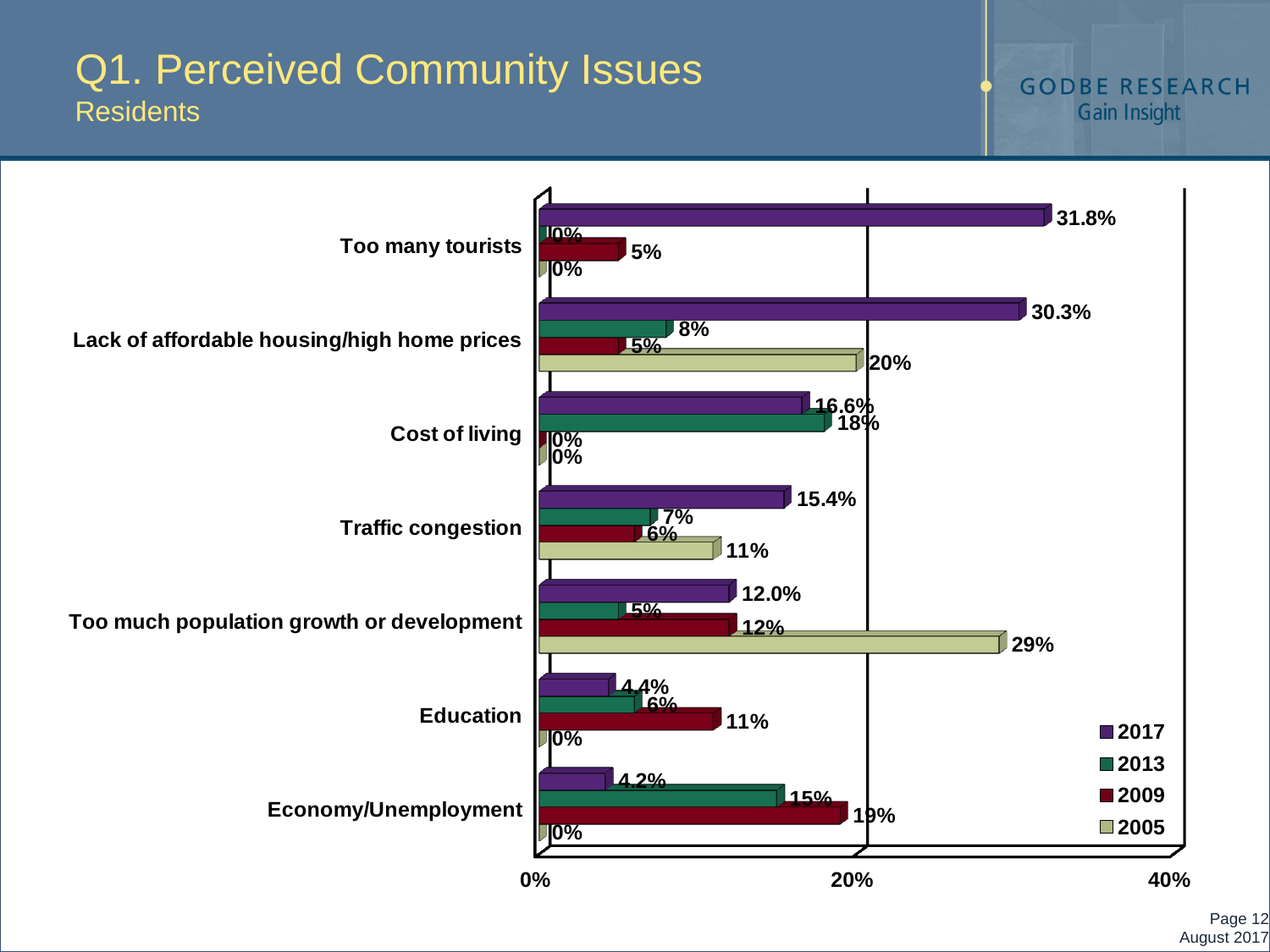
Which is larger for Traffic congestion: the 2017 value or the 2005 value? 2017 What is the 2009 value for Economy/Unemployment? 19% What is the difference between the 2017 and 2005 values for Lack of affordable housing/high home prices? 10.3% Which category has the highest 2017 value? Too many tourists How many series does the legend list? 4 What is the 2013 value for Cost of living? 18% How many categories are shown on the chart? 7 Is the 2005 value for Too much population growth or development greater or less than 20%? greater What is the 2017 value for Too many tourists? 31.8% What is the 2005 value for Too much population growth or development? 29% Which category has the lowest 2017 value? Economy/Unemployment What kind of chart is shown on the slide? Bar chart